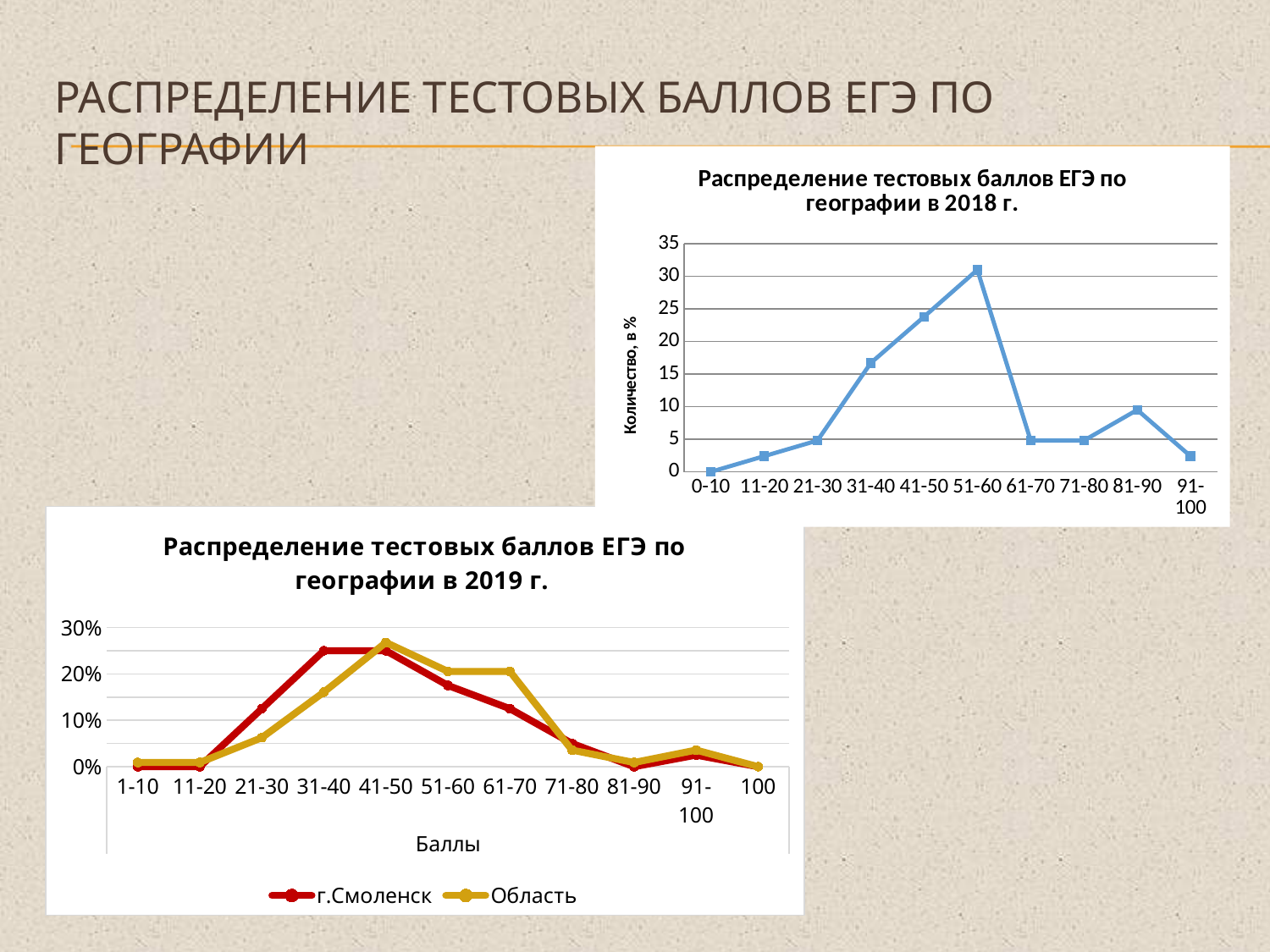
In the 2019 chart, which series has the larger value at 31-40, г.Смоленск or Область? г.Смоленск In the 2018 chart, what is the label of the vertical axis? Количество, в % In the 2019 chart, is the value for Область at 21-30 greater or less than 10%? less What kind of chart is the chart titled "Распределение тестовых баллов ЕГЭ по географии в 2018 г."? line chart In the 2018 chart, is the value for 51-60 greater or less than 30? greater In the 2018 chart, is the value for 31-40 greater or less than 15? greater How many series does the legend of the 2019 chart list? 2 In the 2018 chart, how many score ranges are plotted along the x axis? 10 In the 2018 chart, do the values rise or fall from 0-10 to 51-60? rise In the 2018 chart, which score range has the highest value? 51-60 In the 2019 chart, which series has the larger value at 61-70, г.Смоленск or Область? Область In the 2019 chart, how many score ranges are plotted along the x axis? 11